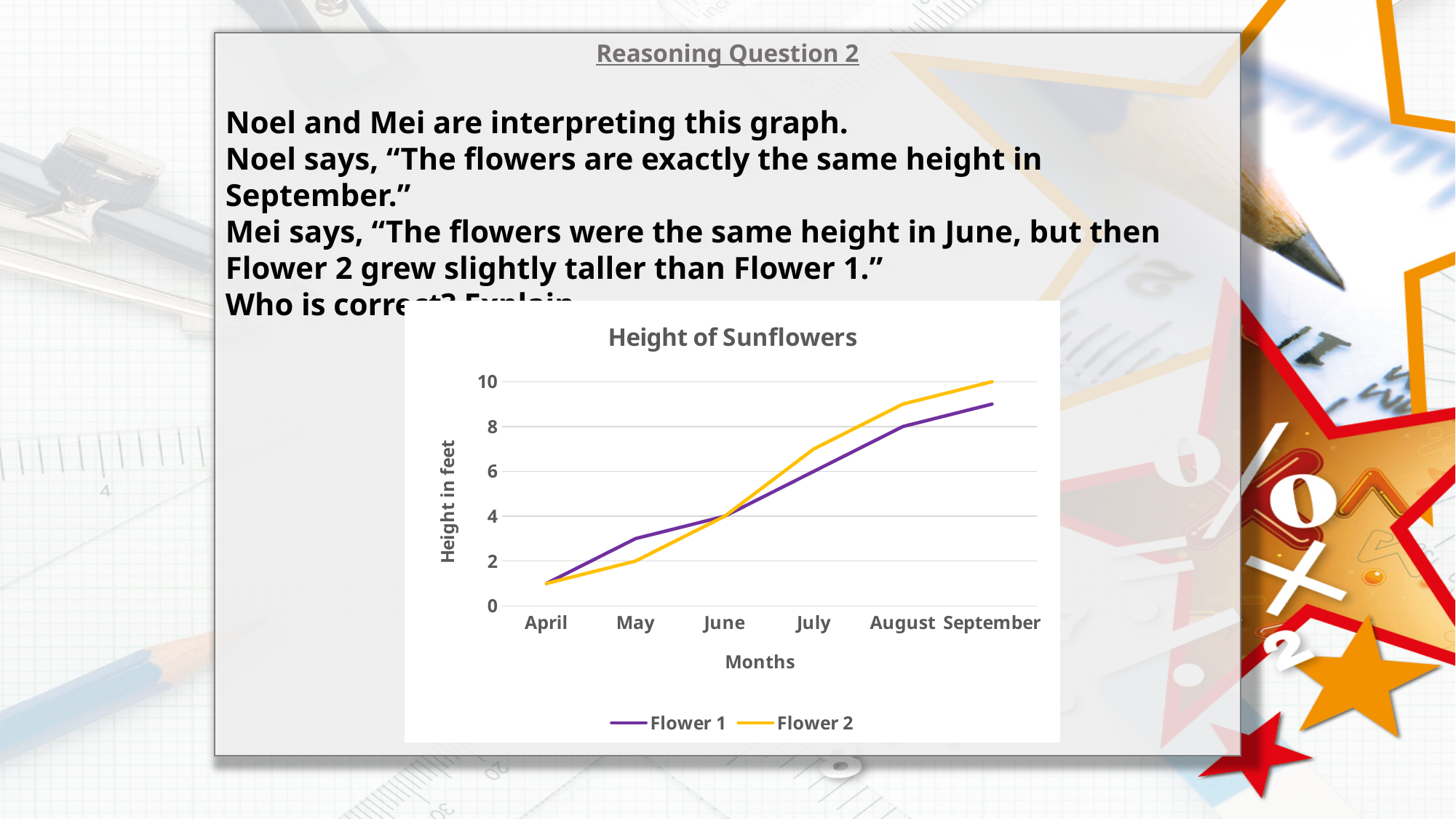
How many series does the legend list? 2 Which flower is taller in September, Flower 1 or Flower 2? Flower 2 What is the height of Flower 2 in May? 2 Is the value for Flower 1 in September greater or less than 8? greater Is the value for Flower 2 in April greater or less than 2? less Do the heights of the flowers rise or fall from April to September? rise What is the height of Flower 1 in August? 8 What kind of chart is shown on the slide? line chart What is the height of Flower 2 in September? 10 How many months are shown on the x axis? 6 Which flower is taller in May, Flower 1 or Flower 2? Flower 1 What is the title of the chart? Height of Sunflowers